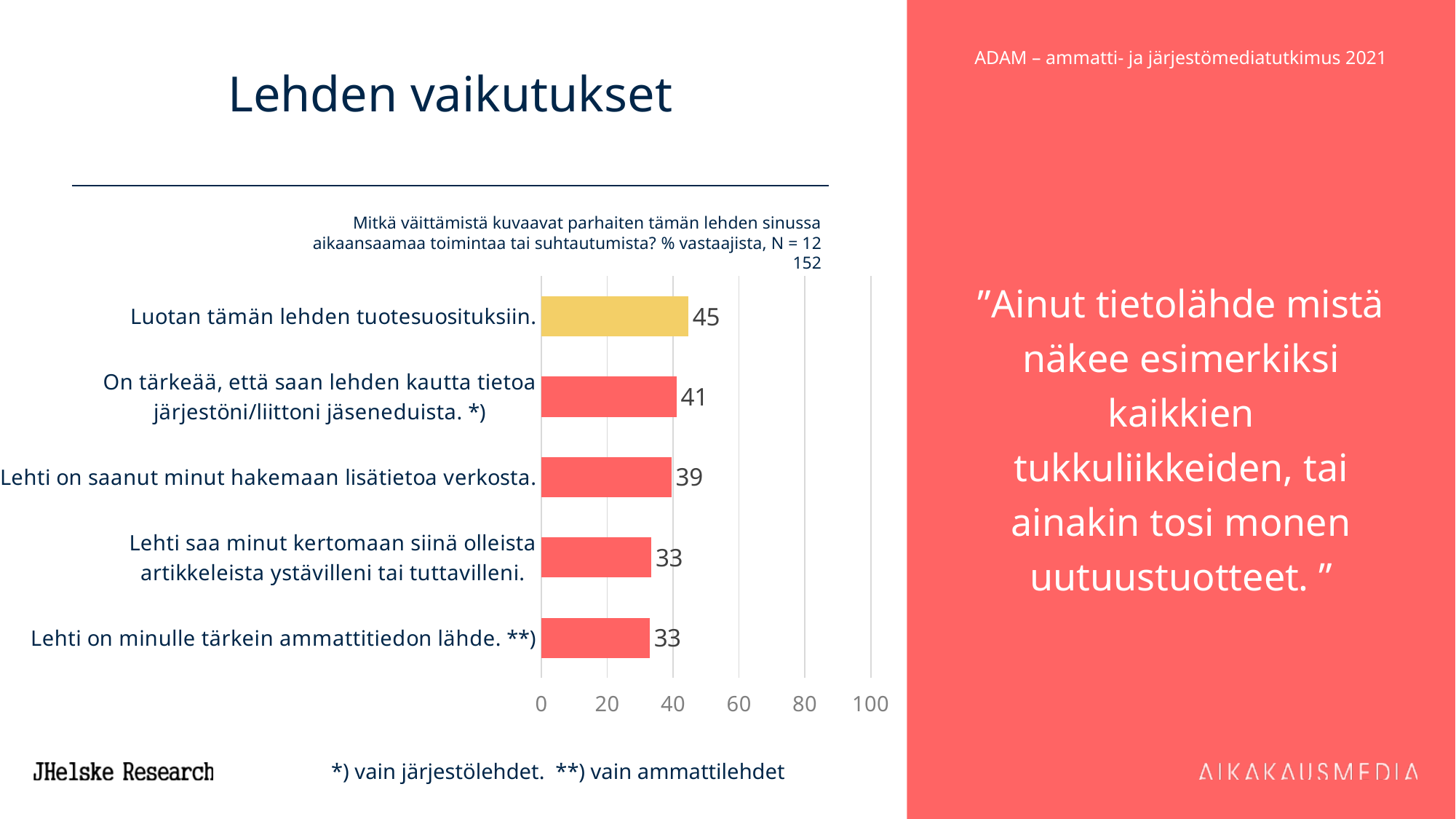
What is the maximum value shown on the x axis? 100 What is the difference between the values for "Luotan tämän lehden tuotesuosituksiin." and "Lehti on minulle tärkein ammattitiedon lähde. **)"? 12 What is the value for "Luotan tämän lehden tuotesuosituksiin."? 45 Is the value for "Lehti saa minut kertomaan siinä olleista artikkeleista ystävilleni tai tuttavilleni." greater or less than 40? less How many categories are shown in the chart? 5 Which category has the highest value? Luotan tämän lehden tuotesuosituksiin. What is the value for "On tärkeää, että saan lehden kautta tietoa järjestöni/liittoni jäseneduista. *)"? 41 What kind of chart is shown on the slide? bar chart What is the value for "Lehti on minulle tärkein ammattitiedon lähde. **)"? 33 Which bar is coloured differently (yellow) from the others? Luotan tämän lehden tuotesuosituksiin. What is the value for "Lehti on saanut minut hakemaan lisätietoa verkosta."? 39 Which is larger: the value for "On tärkeää, että saan lehden kautta tietoa järjestöni/liittoni jäseneduista. *)" or the value for "Lehti on saanut minut hakemaan lisätietoa verkosta."? On tärkeää, että saan lehden kautta tietoa järjestöni/liittoni jäseneduista. *)